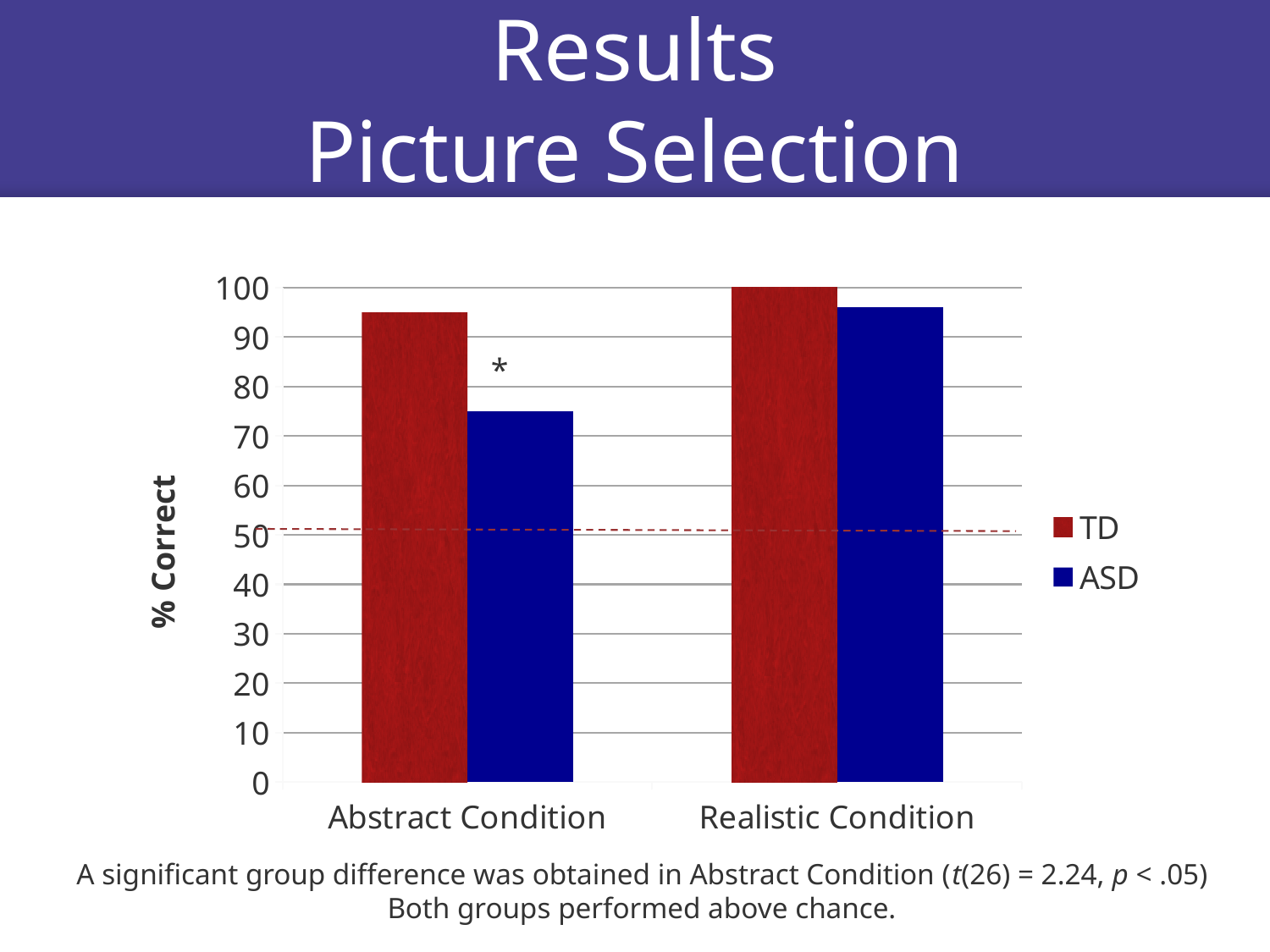
Is the value for ASD in the Realistic Condition greater or less than 90? greater Is the value for ASD in the Abstract Condition greater or less than 80? less In the Abstract Condition, which group has the higher % Correct, TD or ASD? TD What is the % Correct value for TD in the Realistic Condition? 100 Which bar has the lowest % Correct in the chart? ASD, Abstract Condition Which series is shown in blue in the legend? ASD How many condition categories are shown on the x axis? 2 What is the label of the y axis? % Correct Which bar has the highest % Correct in the chart? TD, Realistic Condition What kind of chart is shown on the slide? bar chart Is the value for TD in the Abstract Condition greater or less than 90? greater How many series does the legend list? 2